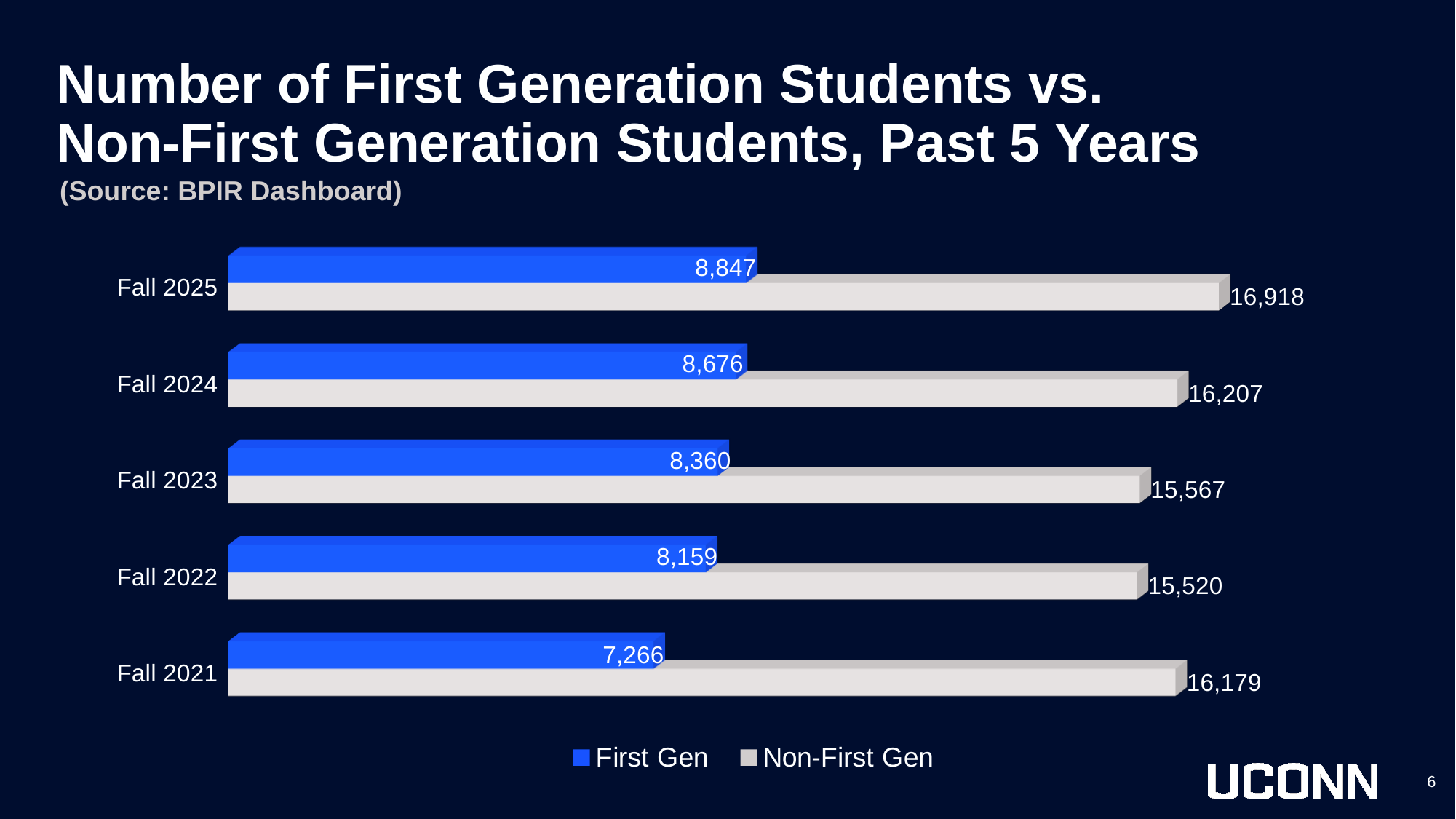
Does the number of First Gen students rise or fall from Fall 2021 to Fall 2025? Rise What is the number of First Gen students in Fall 2021? 7,266 What is the difference between Non-First Gen and First Gen students in Fall 2024? 7,531 How many series does the legend list? 2 Which is larger: the number of Non-First Gen students in Fall 2022 or in Fall 2021? Fall 2021 What is the number of Non-First Gen students in Fall 2023? 15,567 What kind of chart is shown on the slide? Bar chart How much did the number of First Gen students increase from Fall 2021 to Fall 2025? 1,581 Which year has the highest number of Non-First Gen students? Fall 2025 How many years (categories) are shown in the chart? 5 What is the number of First Gen students in Fall 2025? 8,847 Which year has the lowest number of First Gen students? Fall 2021